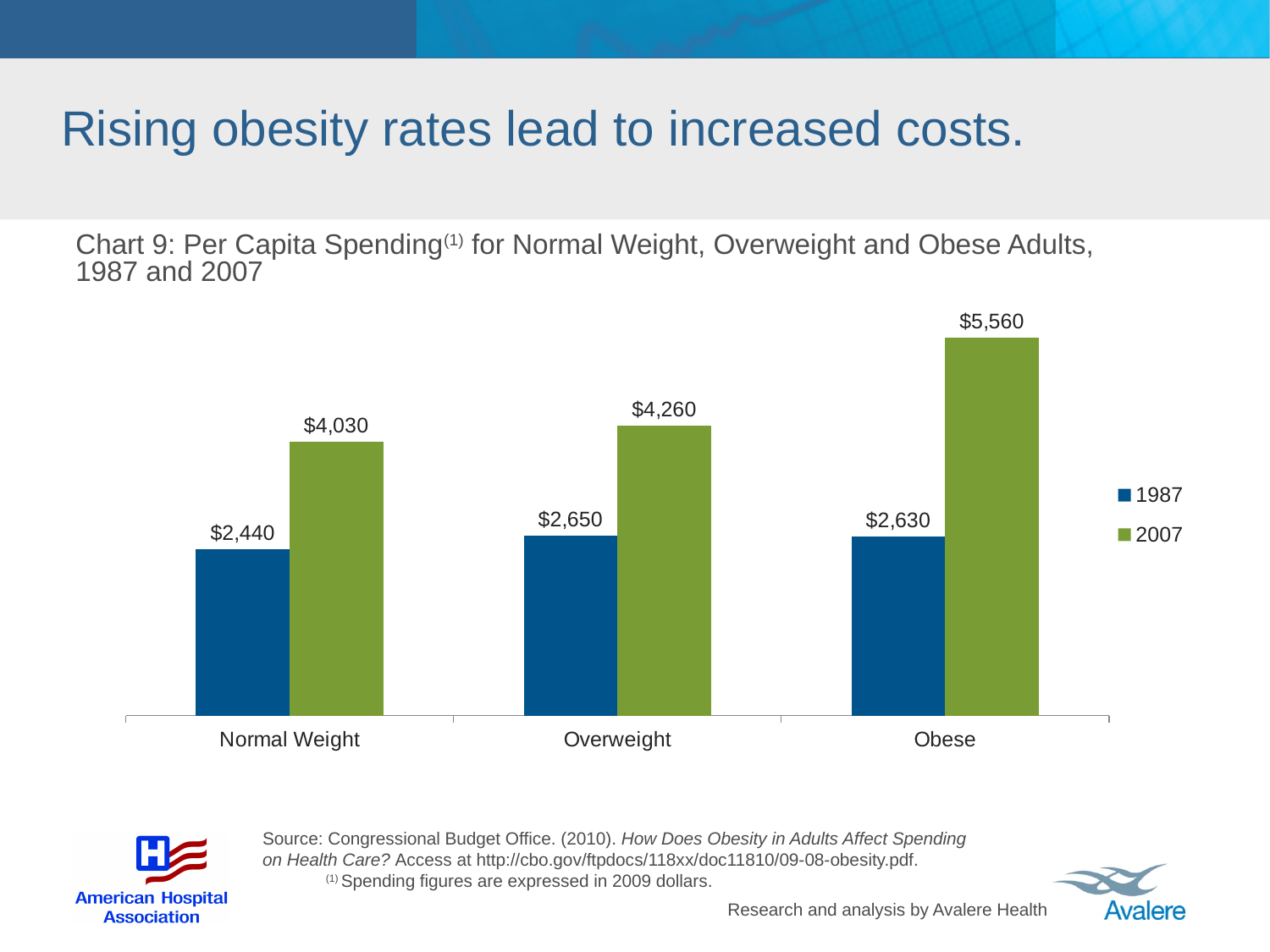
What is the difference between 2007 and 1987 per capita spending for Obese adults? $2,930 Which weight category had the lowest per capita spending in 1987? Normal Weight What was per capita spending for Obese adults in 2007? $5,560 Which is larger: 1987 spending for Overweight adults or 1987 spending for Normal Weight adults? Overweight Which colour represents the 2007 series in the legend? Green What was per capita spending for Overweight adults in 2007? $4,260 What was per capita spending for Normal Weight adults in 1987? $2,440 How many series does the legend list? 2 What is the difference in 2007 per capita spending between Obese and Normal Weight adults? $1,530 What kind of chart is shown on the slide? Bar chart How many weight categories are shown on the x axis? 3 Which weight category had the highest per capita spending in 2007? Obese